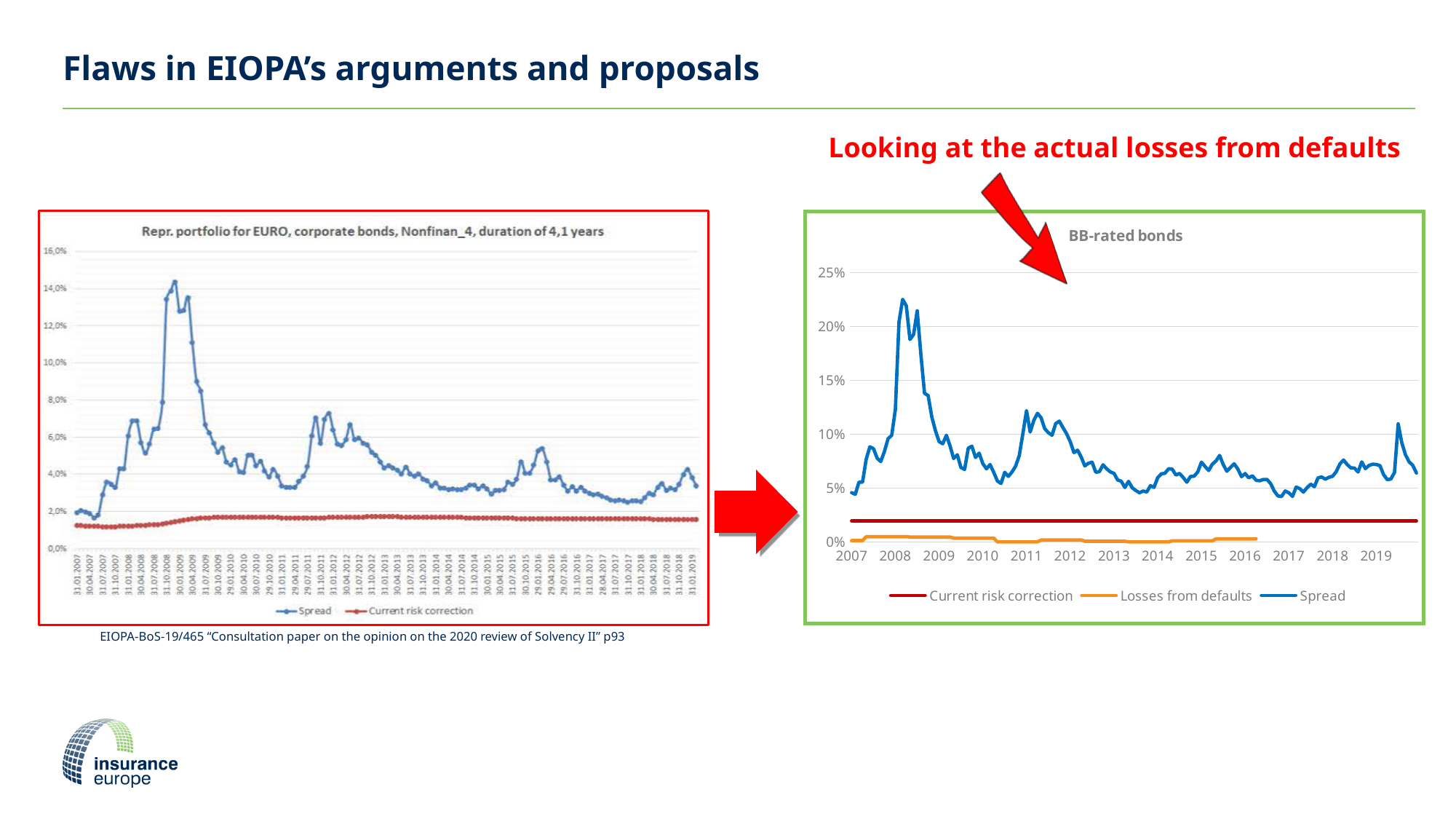
In the left chart, is the Current risk correction series greater or less than 2,0% throughout the period? less In the right chart 'BB-rated bonds', does the Spread series rise or fall from its 2008 peak to 2010? Fall In the right chart 'BB-rated bonds', which series is larger in 2008: Spread or Losses from defaults? Spread How many series does the legend of the right chart 'BB-rated bonds' list? 3 What is the title of the right chart? BB-rated bonds In the right chart 'BB-rated bonds', is the Losses from defaults series greater or less than 5% throughout the period? less In the right chart 'BB-rated bonds', is the Current risk correction series greater or less than 5%? less In the right chart 'BB-rated bonds', what colour is the Spread line? Blue What kind of chart is the left chart titled 'Repr. portfolio for EURO, corporate bonds, Nonfinan_4, duration of 4,1 years'? Line chart How many series does the legend of the left chart list? 2